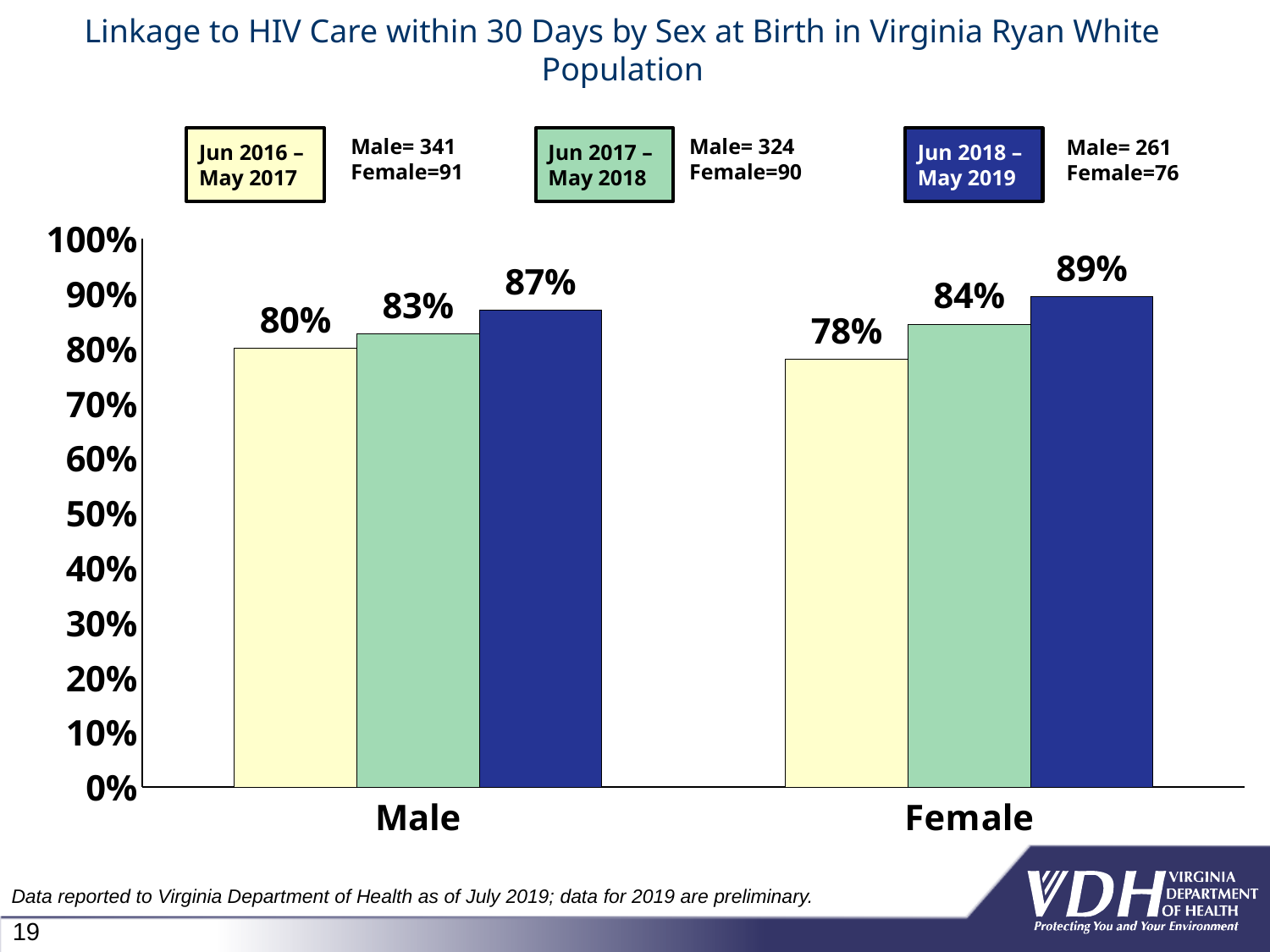
Which sex-at-birth category has the lowest value in Jun 2016 – May 2017? Female What is the difference between the female value in Jun 2018 – May 2019 and the female value in Jun 2016 – May 2017? 11% How many sex-at-birth categories are shown on the x axis? 2 What is the linkage to HIV care within 30 days for males in Jun 2016 – May 2017? 80% What is the difference between the male and female values in Jun 2017 – May 2018? 1% Which period has the highest value for males? Jun 2018 – May 2019 What is the value for females in Jun 2017 – May 2018? 84% What is the linkage to HIV care within 30 days for females in Jun 2018 – May 2019? 89% Which is larger: the male value or the female value in Jun 2018 – May 2019? Female How many time periods (series) does the legend list? 3 What kind of chart is shown on the slide? Bar chart Do the female values rise or fall from Jun 2016 – May 2017 to Jun 2018 – May 2019? Rise